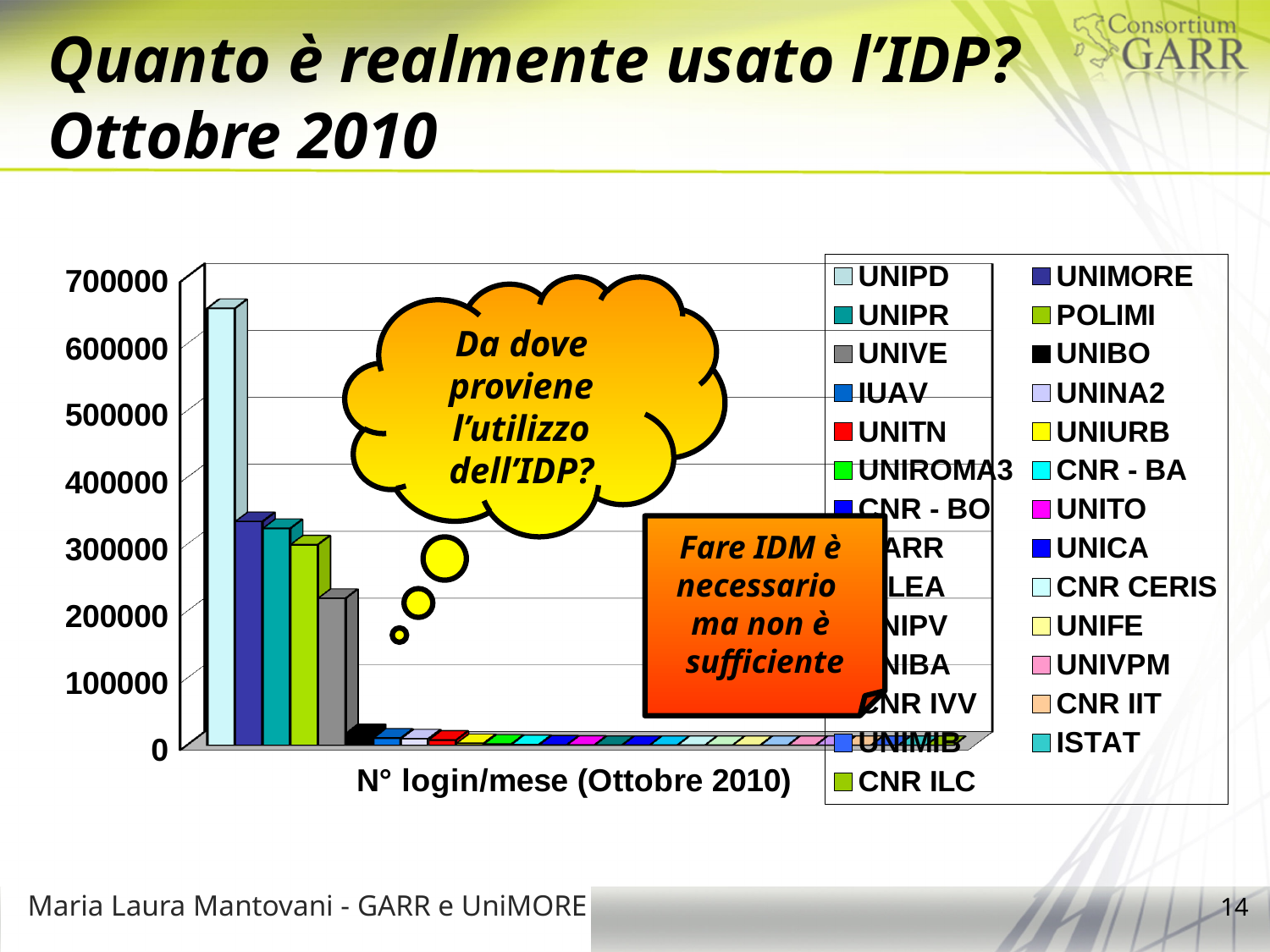
Which institution has the highest number of logins in the chart? UNIPD Is the value for POLIMI greater or less than 400000? less Which is larger, the value for POLIMI or the value for UNIVE? POLIMI What is the highest value shown on the vertical axis? 700000 Which is larger, the value for UNIPD or the value for UNIMORE? UNIPD Is the value for UNIPR greater or less than 200000? greater What kind of chart is shown on the slide? bar chart Is the value for UNIVE greater or less than 300000? less What is the label shown beneath the bars on the horizontal axis? N° login/mese (Ottobre 2010) Do the bar values rise or fall from left to right across the chart? fall